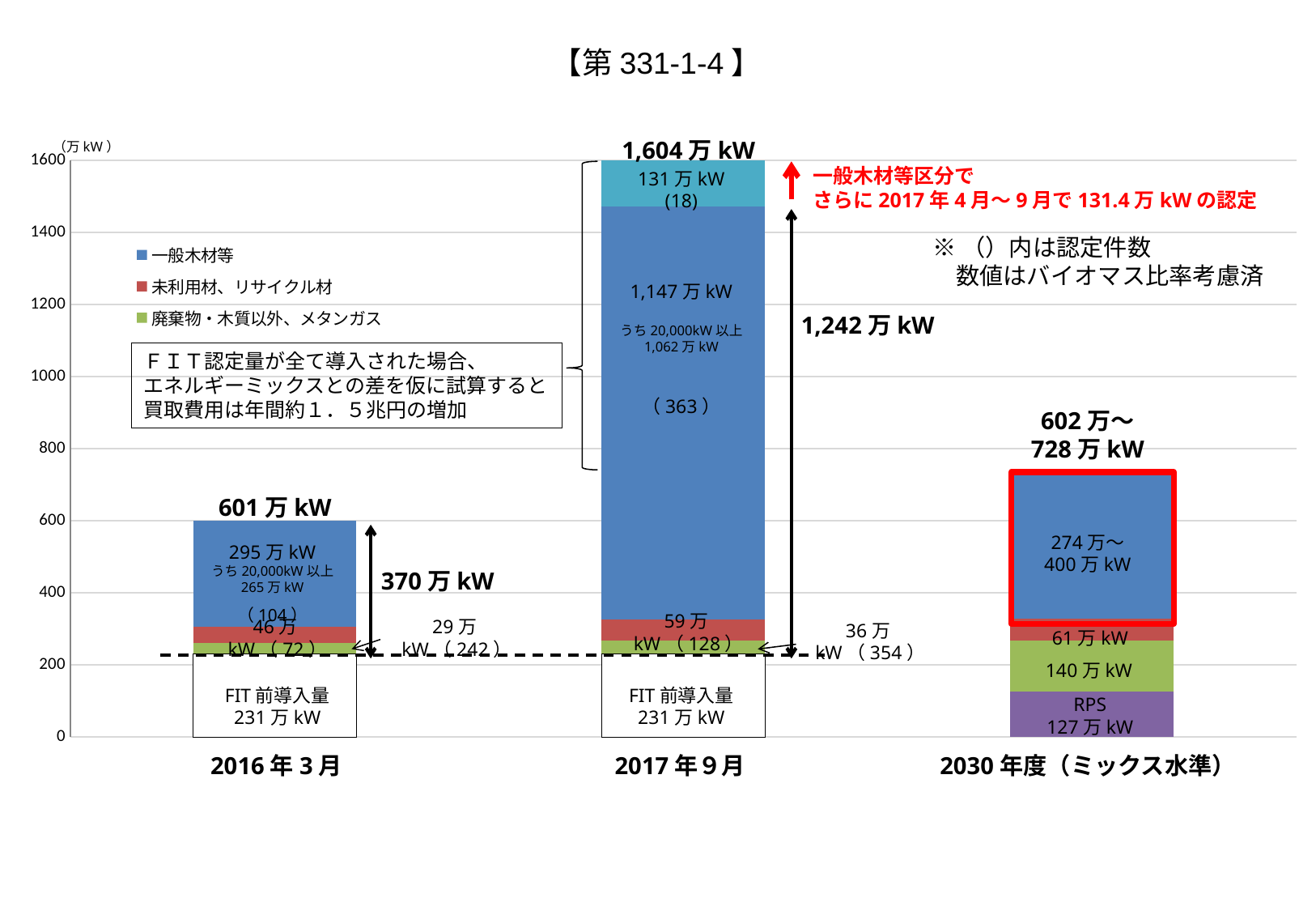
What is the value of 一般木材等 in the 2017年9月 bar? 1,147万kW What is the total value labelled above the bar for 2016年3月? 601万kW How many series does the legend list? 3 How many categories are shown on the x axis? 3 What is the difference between the total for 2017年9月 (1,604万kW) and the total for 2016年3月 (601万kW)? 1,003万kW What is the RPS value in the 2030年度（ミックス水準） bar? 127万kW What is the value of 未利用材、リサイクル材 in the 2016年3月 bar? 46万kW What is the total value labelled above the bar for 2017年9月? 1,604万kW Which category has the tallest bar? 2017年9月 Which is larger: the 未利用材、リサイクル材 value in 2017年9月 or in 2016年3月? 2017年9月 What is the first entry listed in the legend? 一般木材等 What kind of chart is shown on the slide? stacked bar chart